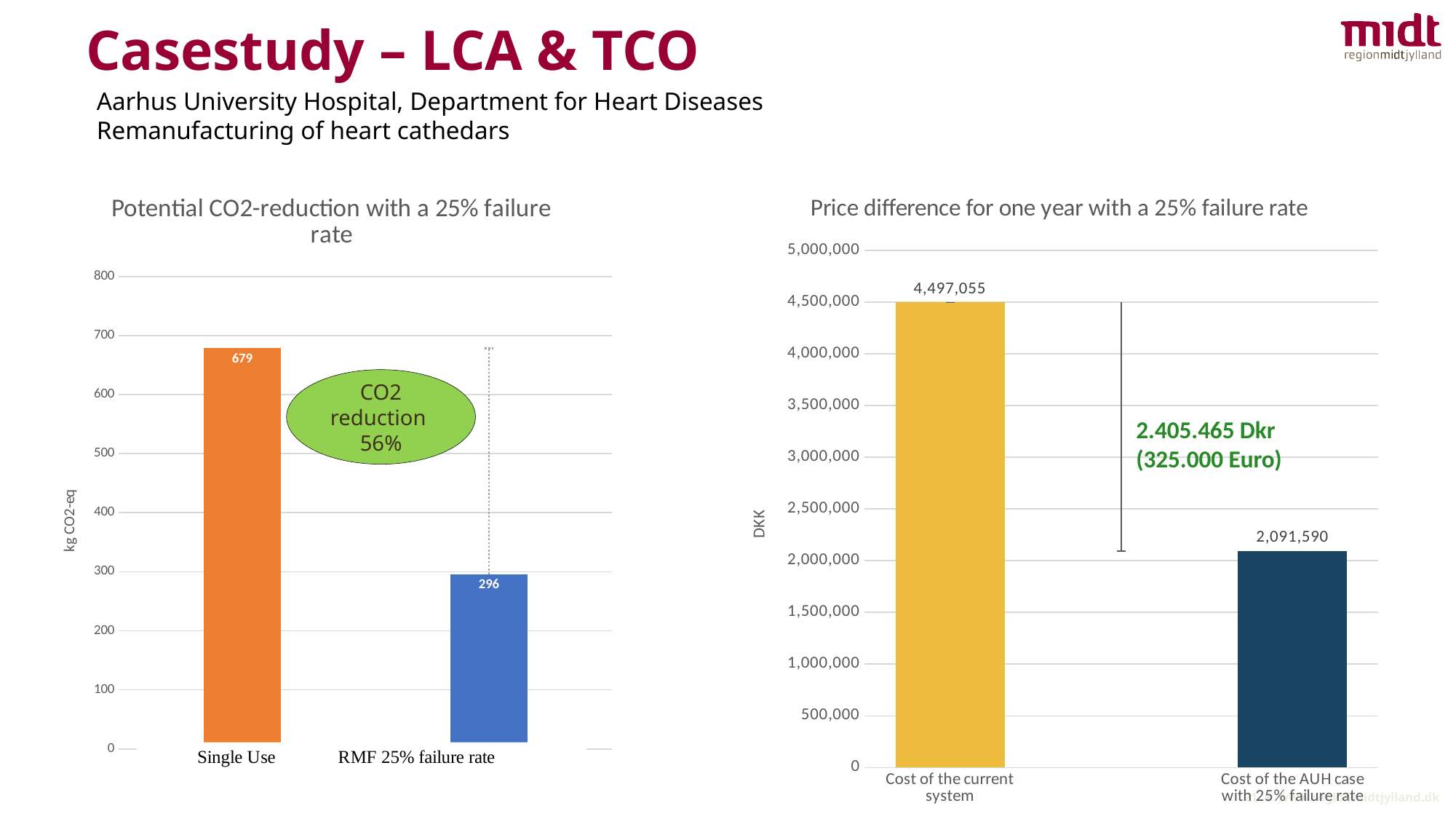
In the 'Potential CO2-reduction with a 25% failure rate' chart, which category has the highest value? Single Use In the 'Price difference for one year with a 25% failure rate' chart, what is the cost of the current system? 4,497,055 In the 'Price difference for one year with a 25% failure rate' chart, is the cost of the current system greater or less than 4,000,000? greater In the 'Potential CO2-reduction with a 25% failure rate' chart, what is the value for Single Use? 679 In the 'Potential CO2-reduction with a 25% failure rate' chart, what kind of chart is shown? Bar chart In the 'Price difference for one year with a 25% failure rate' chart, what is the cost of the AUH case with 25% failure rate? 2,091,590 In the 'Potential CO2-reduction with a 25% failure rate' chart, what is the label of the vertical axis? kg CO2-eq In the 'Price difference for one year with a 25% failure rate' chart, what is the difference between the cost of the current system and the cost of the AUH case? 2,405,465 In the 'Price difference for one year with a 25% failure rate' chart, how many categories are plotted? 2 In the 'Potential CO2-reduction with a 25% failure rate' chart, what is the value for RMF 25% failure rate? 296 In the 'Potential CO2-reduction with a 25% failure rate' chart, what is the difference between Single Use and RMF 25% failure rate? 383 In the 'Price difference for one year with a 25% failure rate' chart, which category has the lowest value? Cost of the AUH case with 25% failure rate